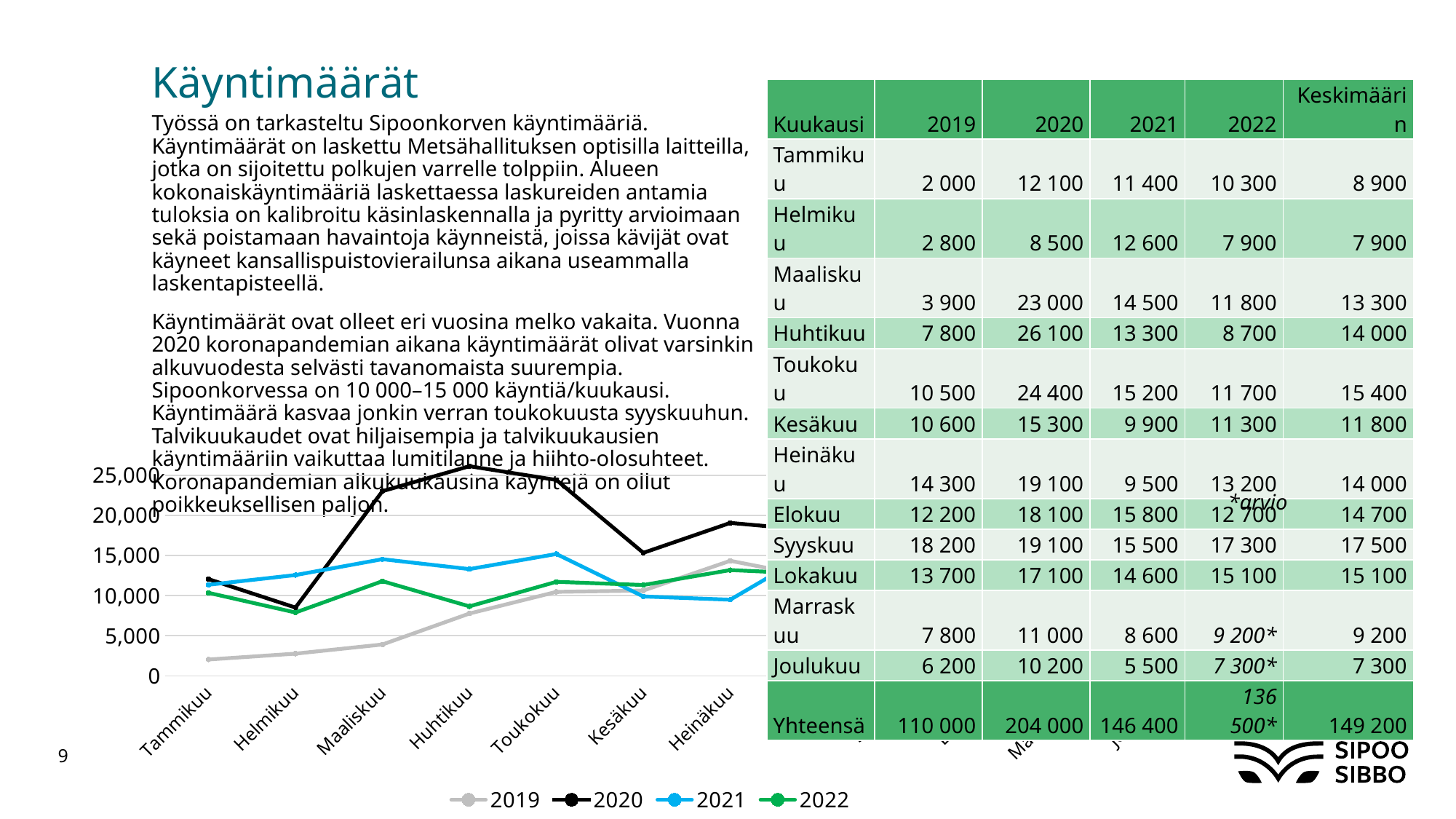
What kind of chart is shown on the slide? line chart Which colour is used for the 2020 line in the chart? black According to the table on the slide, what is the value for 2020 in Huhtikuu? 26 100 In which month does the 2020 line reach its highest point? Huhtikuu Is the value for 2022 in Helmikuu greater or less than 10,000? less Does the 2019 line rise or fall from Tammikuu to Heinäkuu? rise Is the value for 2020 in Huhtikuu greater or less than 20,000? greater How many series does the chart legend list? 4 Which series has the lowest value in Tammikuu? 2019 Is the value for 2019 in Tammikuu greater or less than 5,000? less Which years are listed in the chart legend? 2019, 2020, 2021, 2022 In Maaliskuu, which is larger: the value for 2020 or the value for 2019? 2020